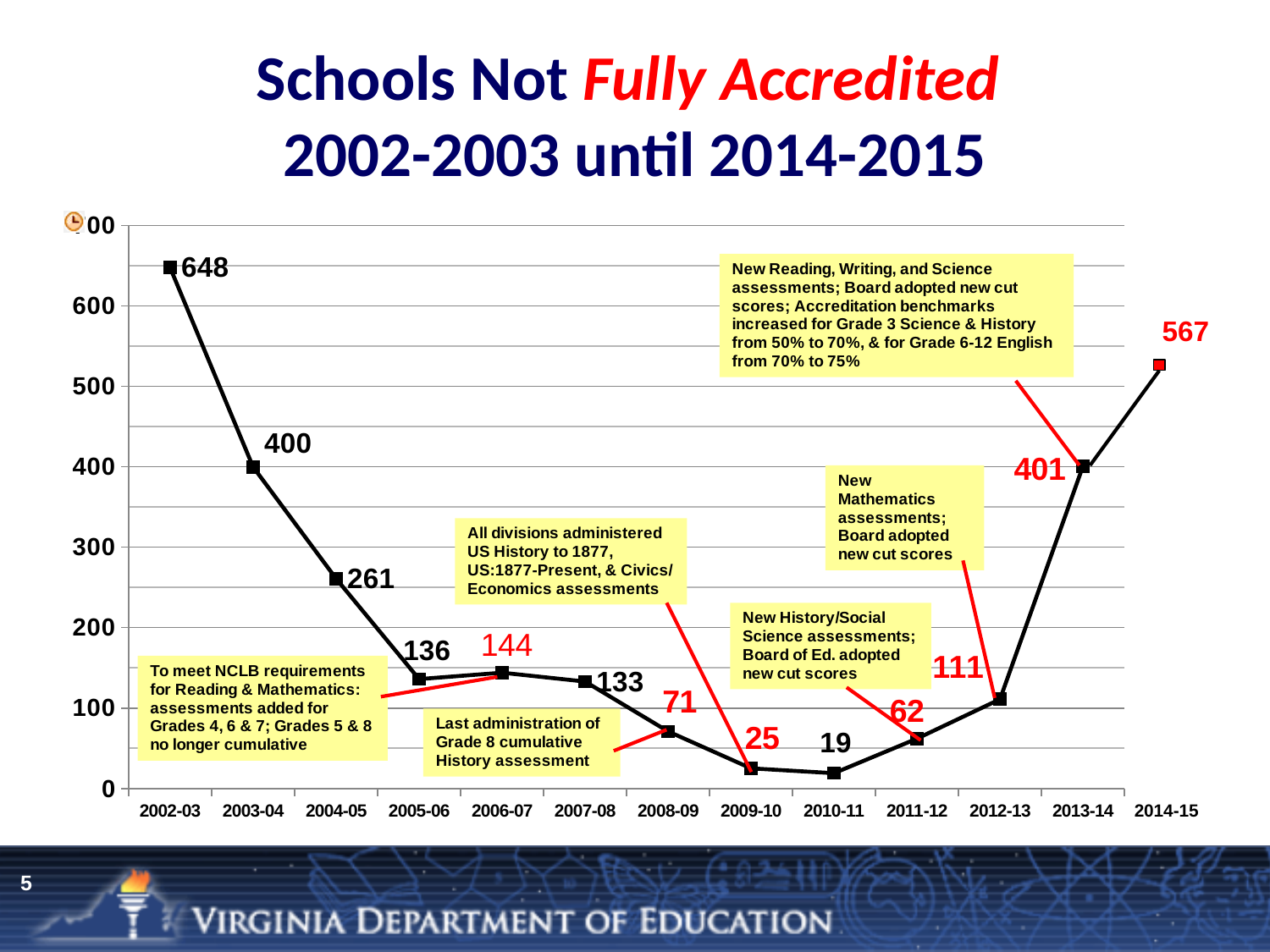
What type of chart is shown on the slide? line chart Do the values rise or fall from 2002-03 to 2010-11? fall How many school years are plotted on the x axis? 13 What is the value for 2010-11? 19 Which school year has the lowest value? 2010-11 What is the value for 2006-07? 144 Which school year has the highest value? 2002-03 What is the value for 2013-14? 401 What is the difference between the values for 2003-04 and 2004-05? 139 What is the value for 2002-03? 648 Which is larger, the value for 2005-06 or the value for 2007-08? 2005-06 What is the title of the chart? Schools Not Fully Accredited 2002-2003 until 2014-2015